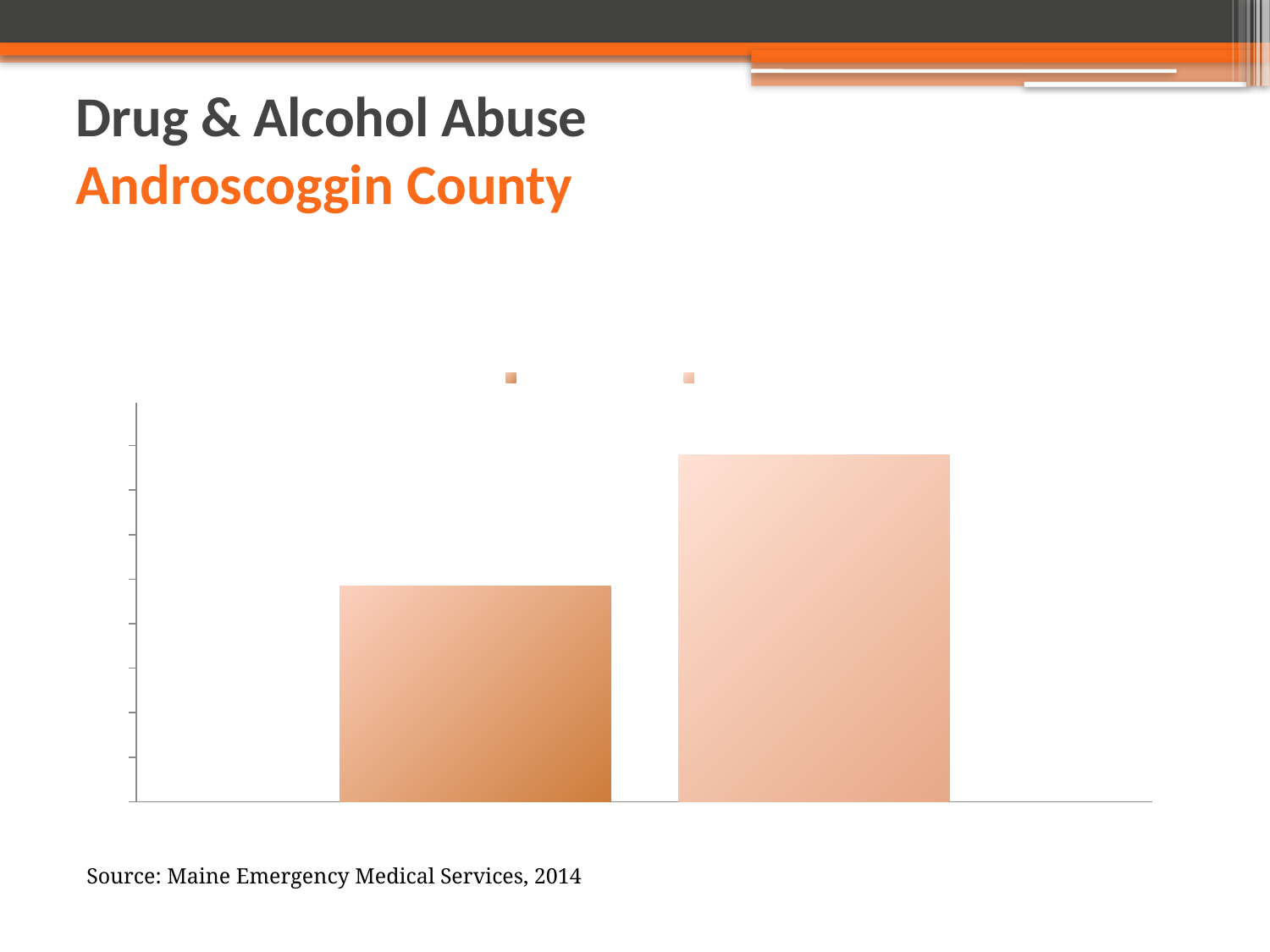
How many entries does the chart's legend show? 2 What kind of chart is shown on the slide? bar chart What source is cited below the chart? Maine Emergency Medical Services, 2014 Which county is named in the slide title above the chart? Androscoggin County Which bar is the shortest, the left bar or the right bar? the left bar Which bar is the tallest, the left bar or the right bar? the right bar Which bar is taller, the left bar or the right bar? the right bar Do the bar heights rise or fall from left to right? rise How many bars are plotted in the chart? 2